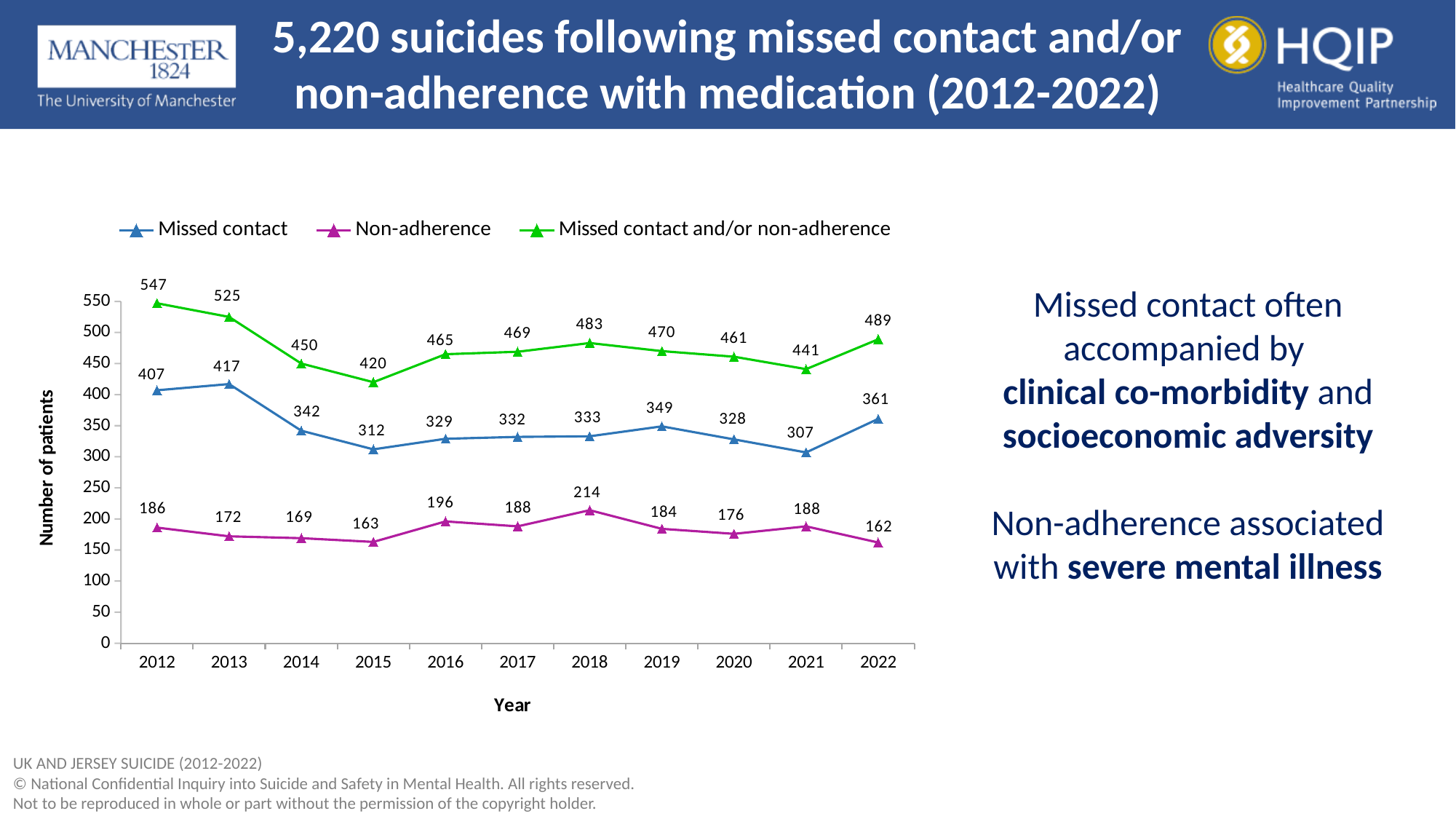
Which is larger: the Non-adherence value in 2016 or in 2017? 2016 What is the label of the y axis? Number of patients How many series does the legend list? 3 What kind of chart is shown on the slide? Line chart What is the difference between the Missed contact and/or non-adherence value and the Missed contact value in 2022? 128 What is the value for Missed contact in 2012? 407 How many years are shown on the x axis? 11 What is the value for Missed contact and/or non-adherence in 2015? 420 What is the value for Non-adherence in 2018? 214 Does the Missed contact and/or non-adherence series rise or fall from 2012 to 2015? Fall In which year is the Missed contact series lowest? 2021 In which year is the Missed contact and/or non-adherence series highest? 2012